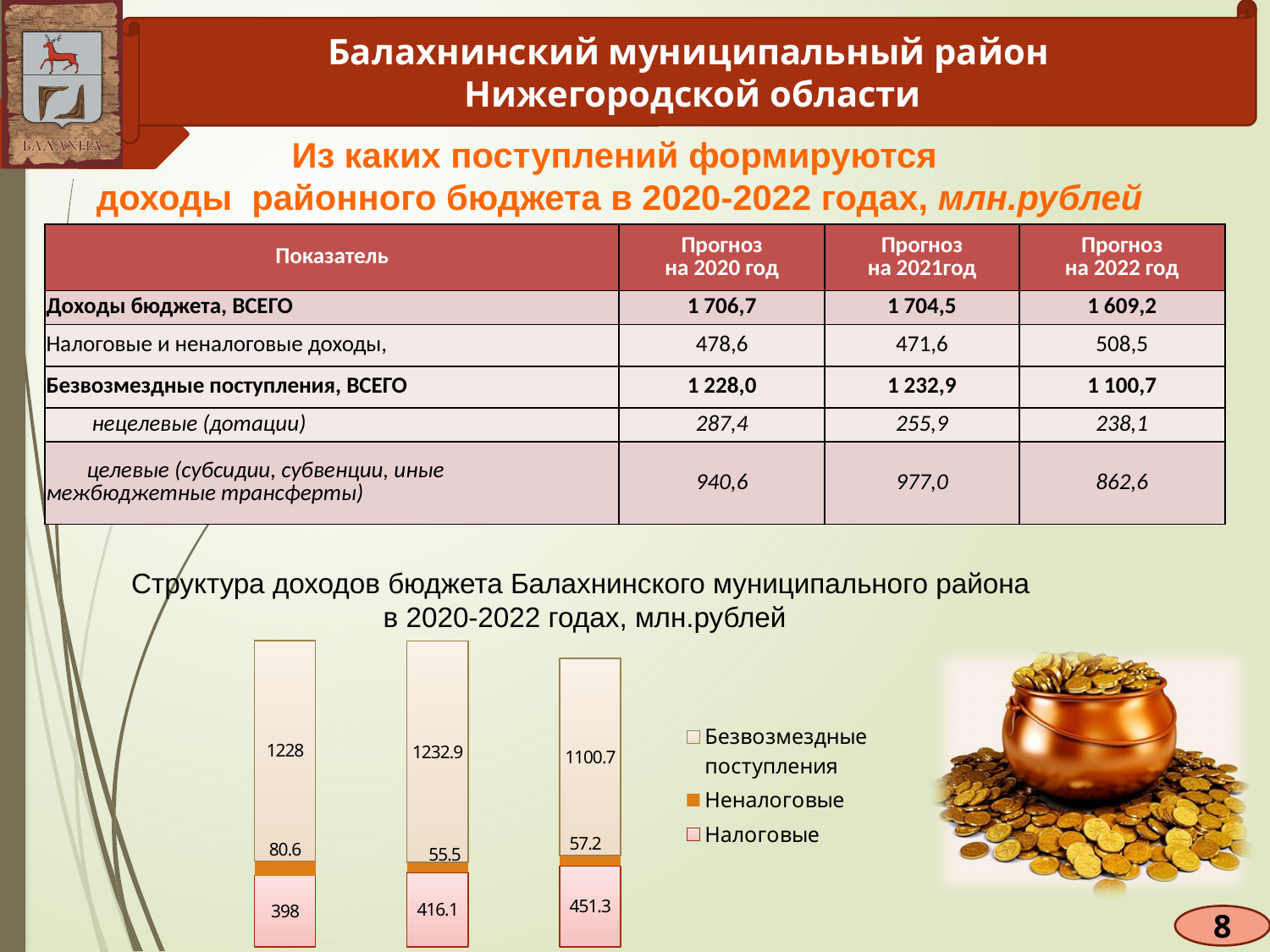
What is the value of 'Безвозмездные поступления' in the leftmost bar of the chart? 1228 Is the 'Неналоговые' value larger in the leftmost bar or the middle bar? the leftmost bar What is the difference between the 'Налоговые' values of the rightmost and leftmost bars? 53.3 How many series does the legend of the chart list? 3 What is the value of 'Налоговые' in the middle bar of the chart? 416.1 Which bar has the highest value for 'Безвозмездные поступления'? the middle bar (1232.9) What is the value of 'Неналоговые' in the rightmost bar of the chart? 57.2 What is the total of the rightmost stacked bar? 1609.2 What type of chart is shown at the bottom of the slide? stacked bar chart Which bar has the lowest value for 'Налоговые'? the leftmost bar (398) How many bars are plotted in the chart 'Структура доходов бюджета Балахнинского муниципального района в 2020-2022 годах'? 3 Do the 'Налоговые' values rise or fall from the leftmost bar to the rightmost bar? rise